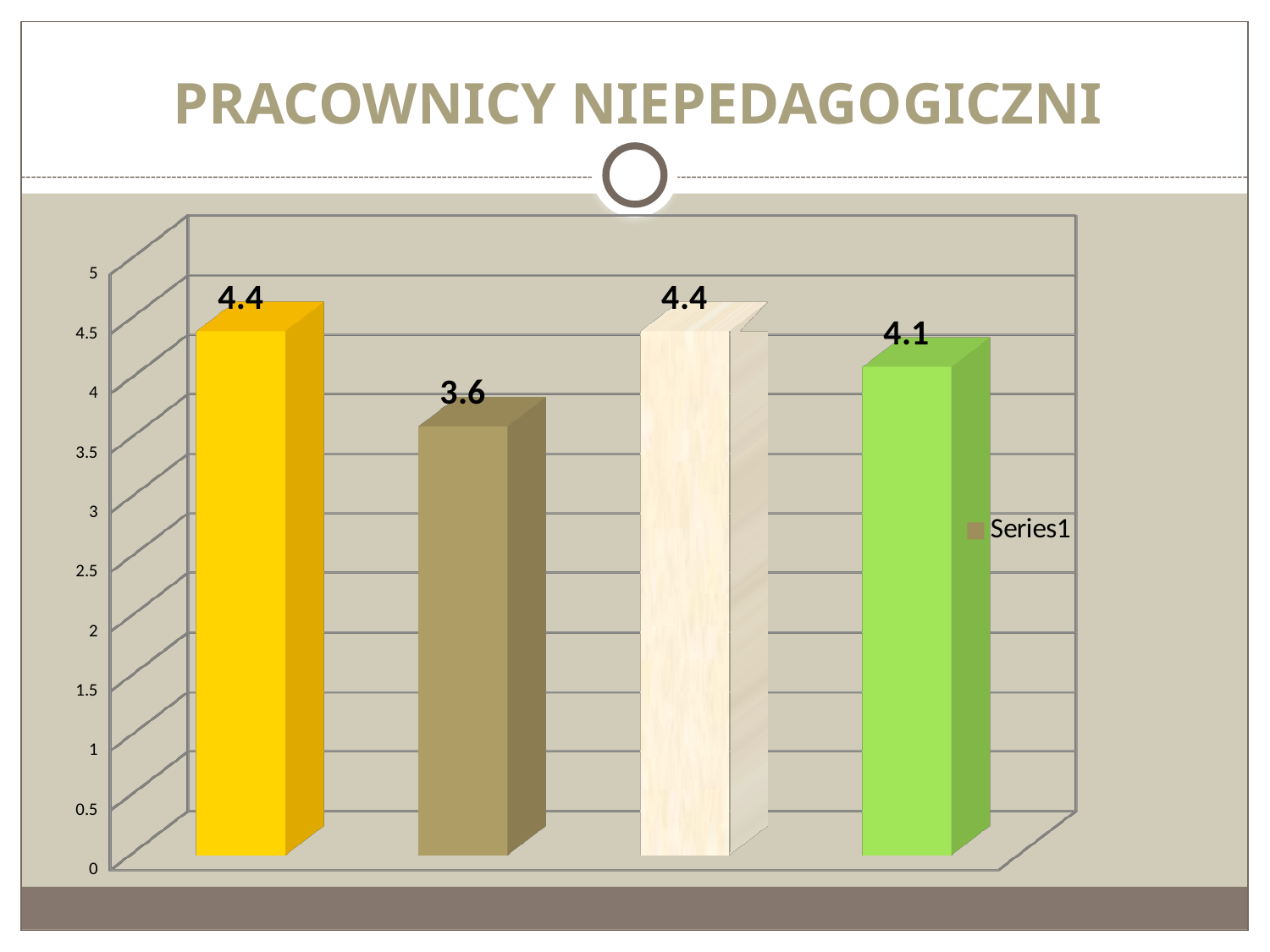
What is the value of the first (yellow) bar from the left? 4.4 What is the value of the second (brown) bar from the left? 3.6 What is the value of the fourth (green) bar from the left? 4.1 How many series does the legend list? 1 Which bar has the lowest value? The second (brown) bar Is the value of the second bar greater or less than 4? less What is the difference between the value of the third bar and the fourth bar? 0.3 What is the difference between the value of the first bar and the second bar? 0.8 What is the value of the third (cream-coloured) bar from the left? 4.4 What kind of chart is shown on the slide? Bar chart Which is larger, the value of the green bar or the brown bar? The green bar How many bars are plotted in the chart? 4